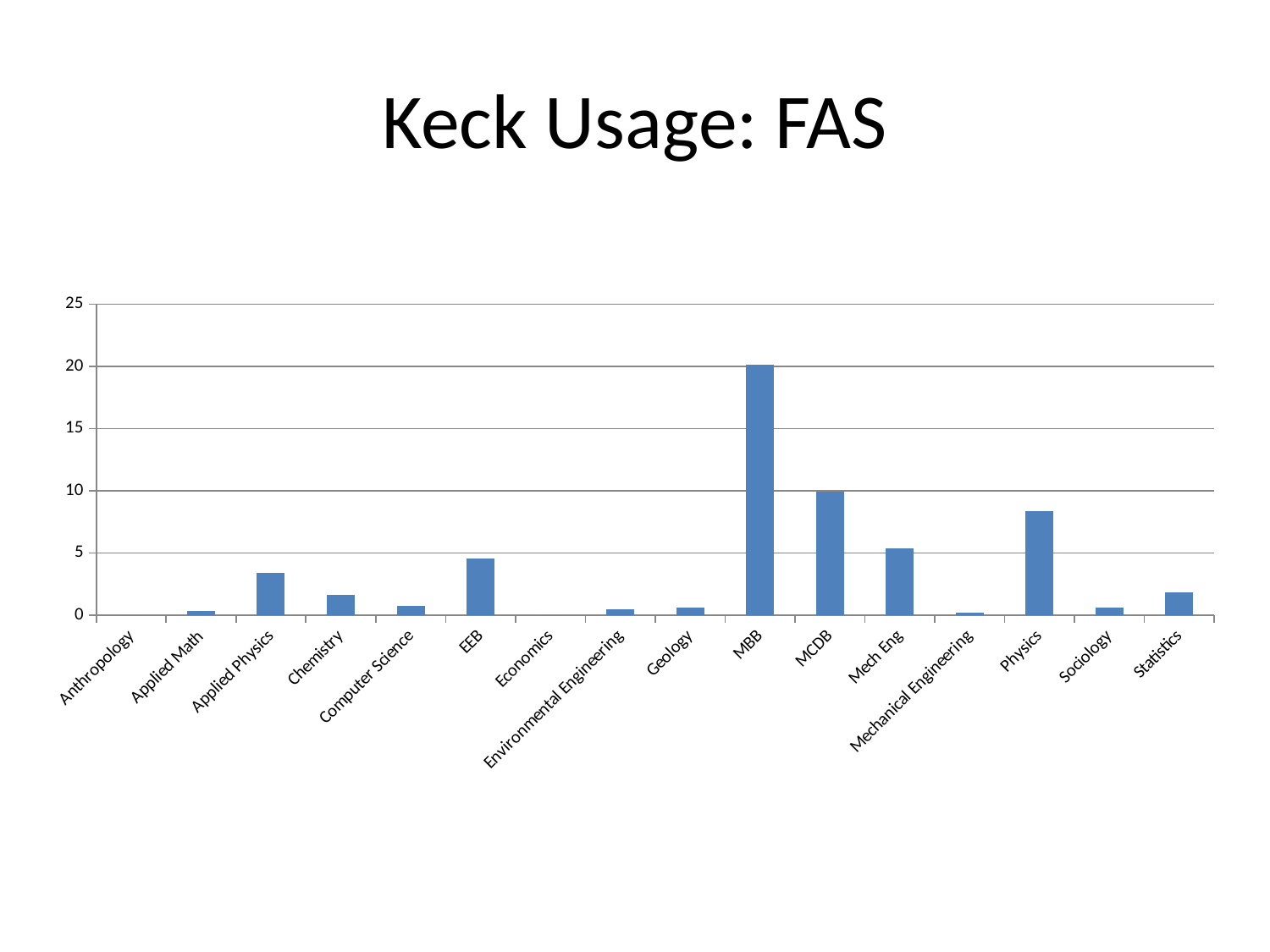
Is the value for EEB greater or less than 5? less Which is larger, the value for Physics or the value for EEB? Physics Is the value for Applied Physics greater or less than 5? less Is the value for Physics greater or less than 5? greater What kind of chart is shown on the slide? bar chart Which is larger, the value for MBB or the value for MCDB? MBB Which is larger, the value for Applied Physics or the value for Chemistry? Applied Physics How many categories are shown on the x axis of the chart? 16 What is the title of the chart? Keck Usage: FAS Which category has the highest value in the chart? MBB